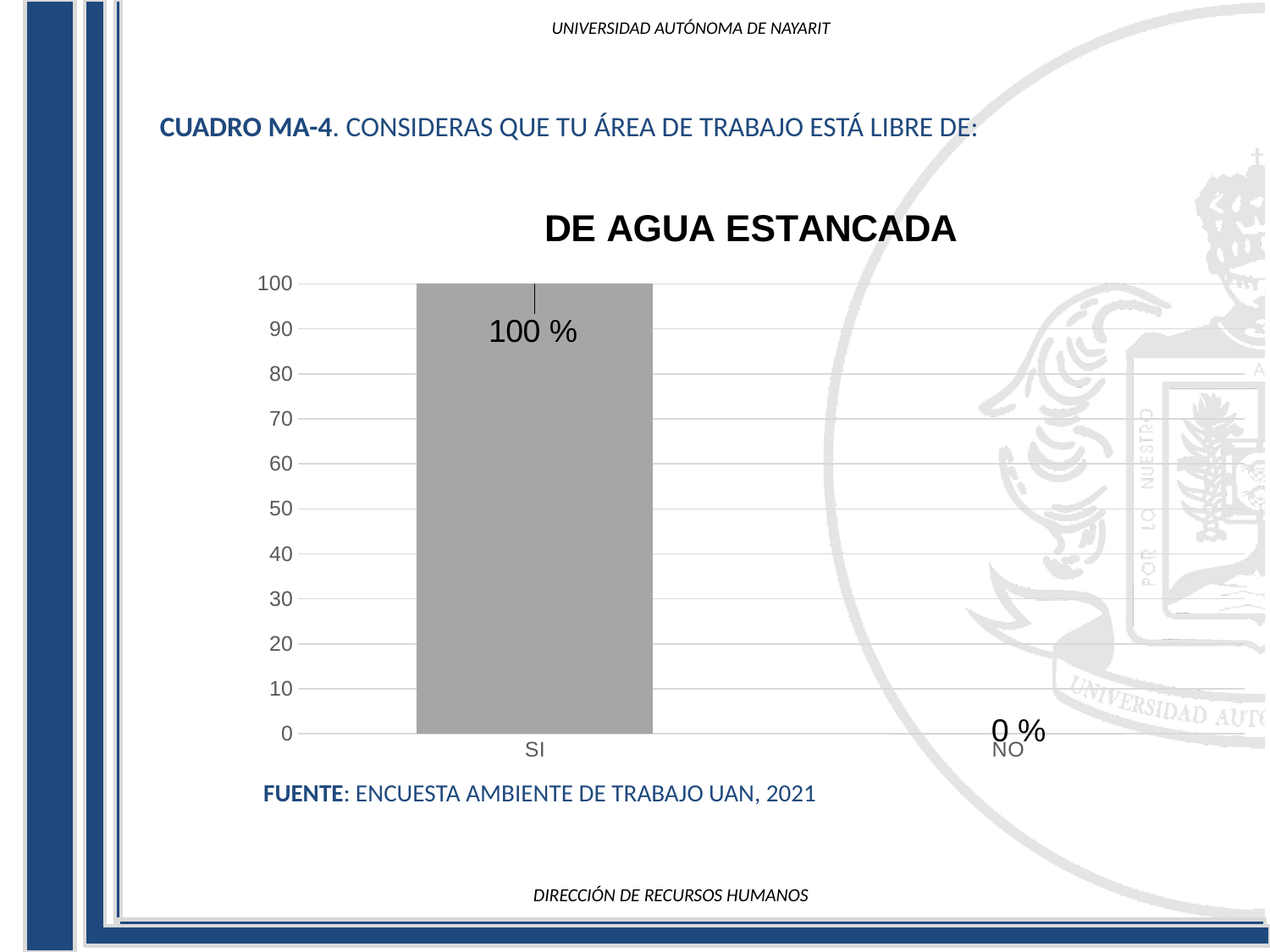
What is the highest value shown on the y axis? 100 What is the value for SI? 100 % Which is larger, the value for SI or the value for NO? SI Which category has the highest value? SI What is the difference between the values for SI and NO? 100 % What kind of chart is shown? bar chart Which category has the lowest value? NO How many categories are shown on the x axis? 2 What is the title of the chart? DE AGUA ESTANCADA Is the value for SI greater or less than 50? greater What is the value for NO? 0 %